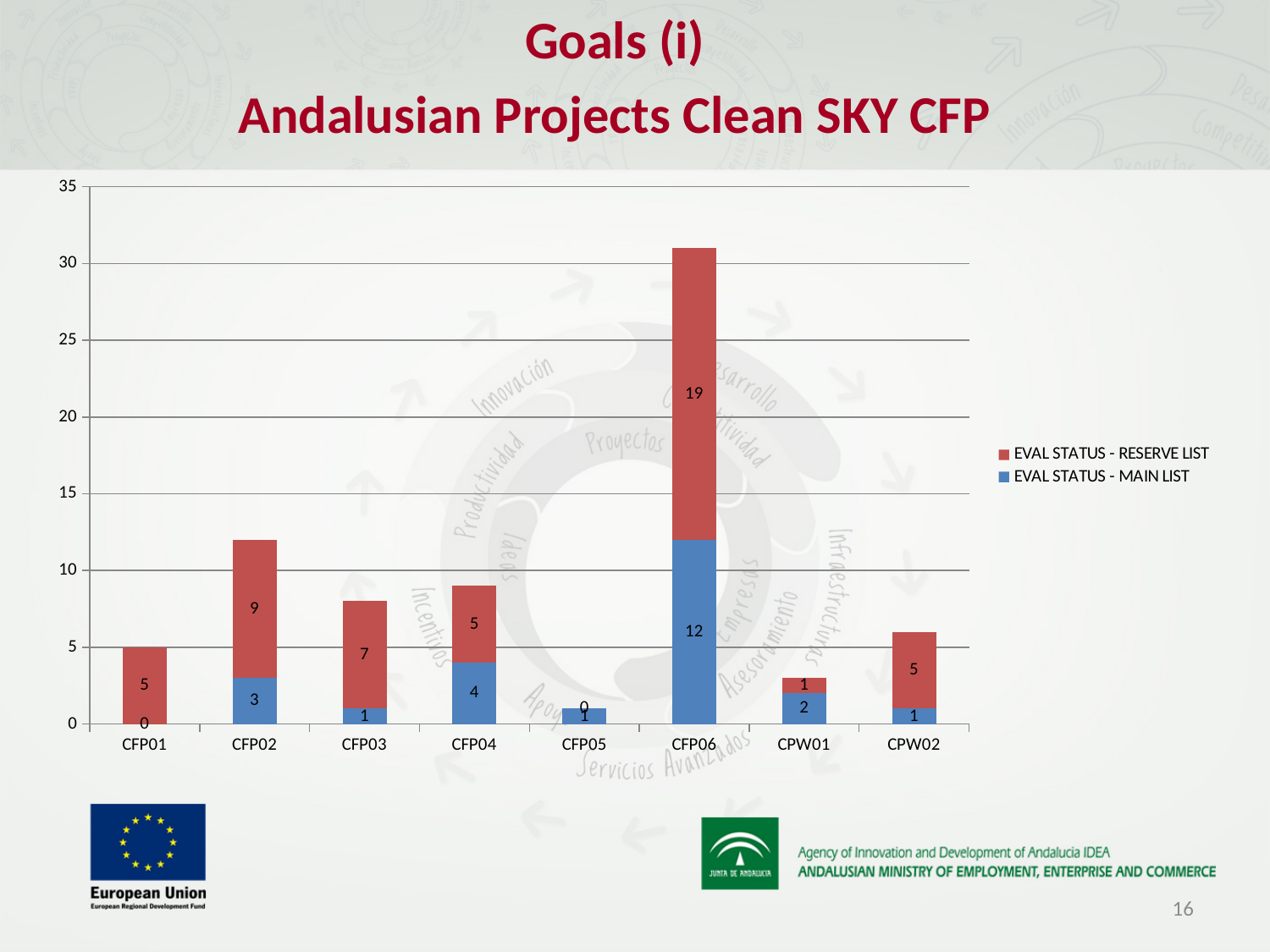
What is the EVAL STATUS - MAIN LIST value for CFP04? 4 What type of chart is shown on the slide? Stacked bar chart What is the difference between the EVAL STATUS - RESERVE LIST values for CFP02 and CFP03? 2 What is the EVAL STATUS - MAIN LIST value for CFP01? 0 Which is larger, the EVAL STATUS - MAIN LIST value for CPW01 or for CPW02? CPW01 What is the total of the stacked bar for CFP06? 31 What is the EVAL STATUS - RESERVE LIST value for CFP06? 19 Which category has the highest EVAL STATUS - MAIN LIST value? CFP06 Which colour represents EVAL STATUS - RESERVE LIST in the legend? Red How many series does the legend list? 2 How many categories are shown on the x axis? 8 Which category has the lowest EVAL STATUS - RESERVE LIST value? CFP05